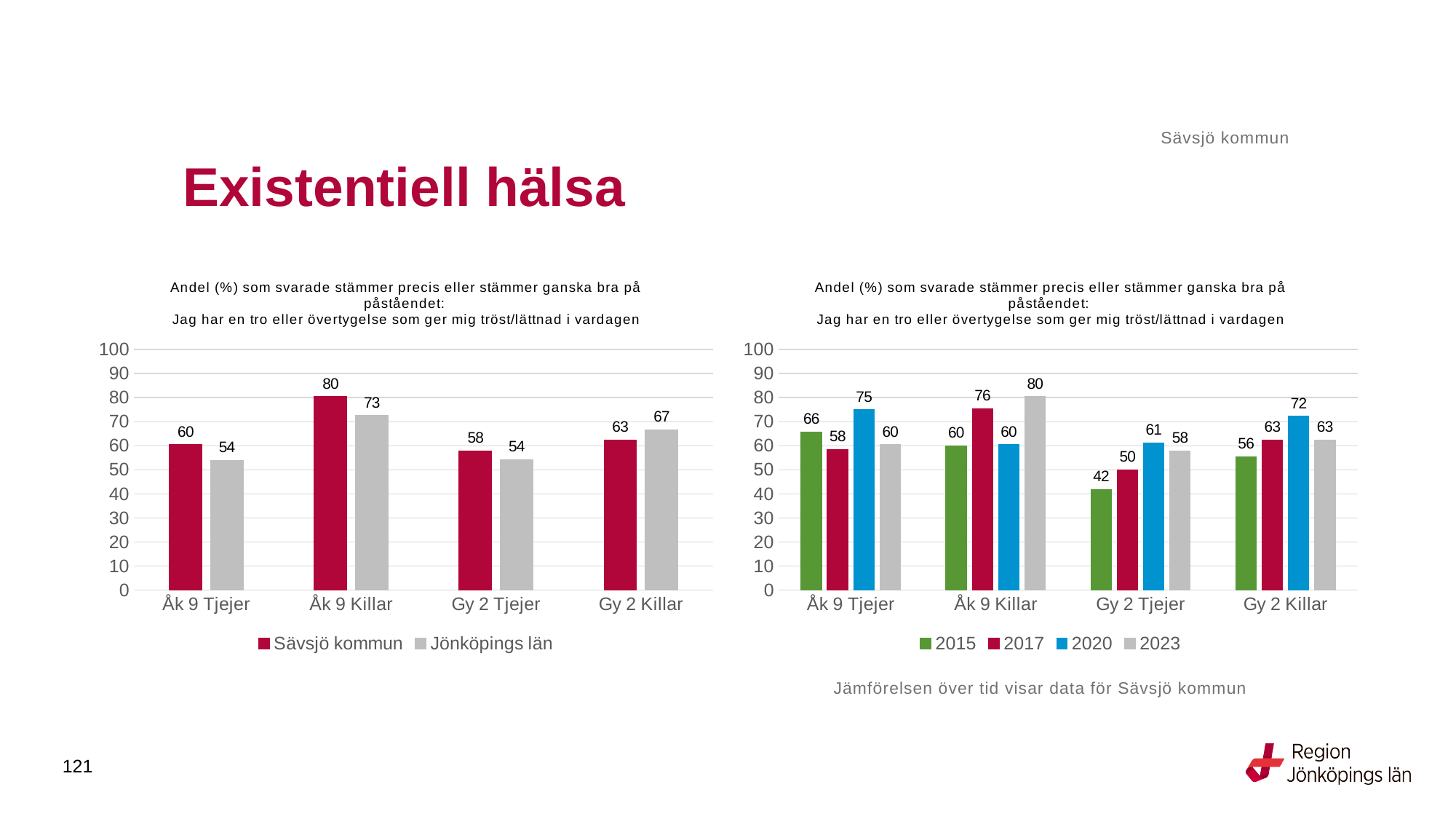
In the left chart, which category has the highest value for Sävsjö kommun? Åk 9 Killar How many series does the legend of the left chart list? 2 In the left chart, which is larger for Gy 2 Killar: Sävsjö kommun or Jönköpings län? Jönköpings län In the right chart, what is the value for 2015 for Gy 2 Tjejer? 42 In the right chart, what is the value for 2020 for Åk 9 Tjejer? 75 In the right chart, which category has the lowest value for 2015? Gy 2 Tjejer In the left chart, what is the value for Sävsjö kommun for Åk 9 Killar? 80 In the left chart, what is the value for Jönköpings län for Gy 2 Tjejer? 54 How many series does the legend of the right chart list? 4 In the left chart, what is the difference between Sävsjö kommun and Jönköpings län for Åk 9 Killar? 7 What type of chart is the right chart? Bar chart In the right chart, what is the difference between the 2023 and 2015 values for Åk 9 Killar? 20